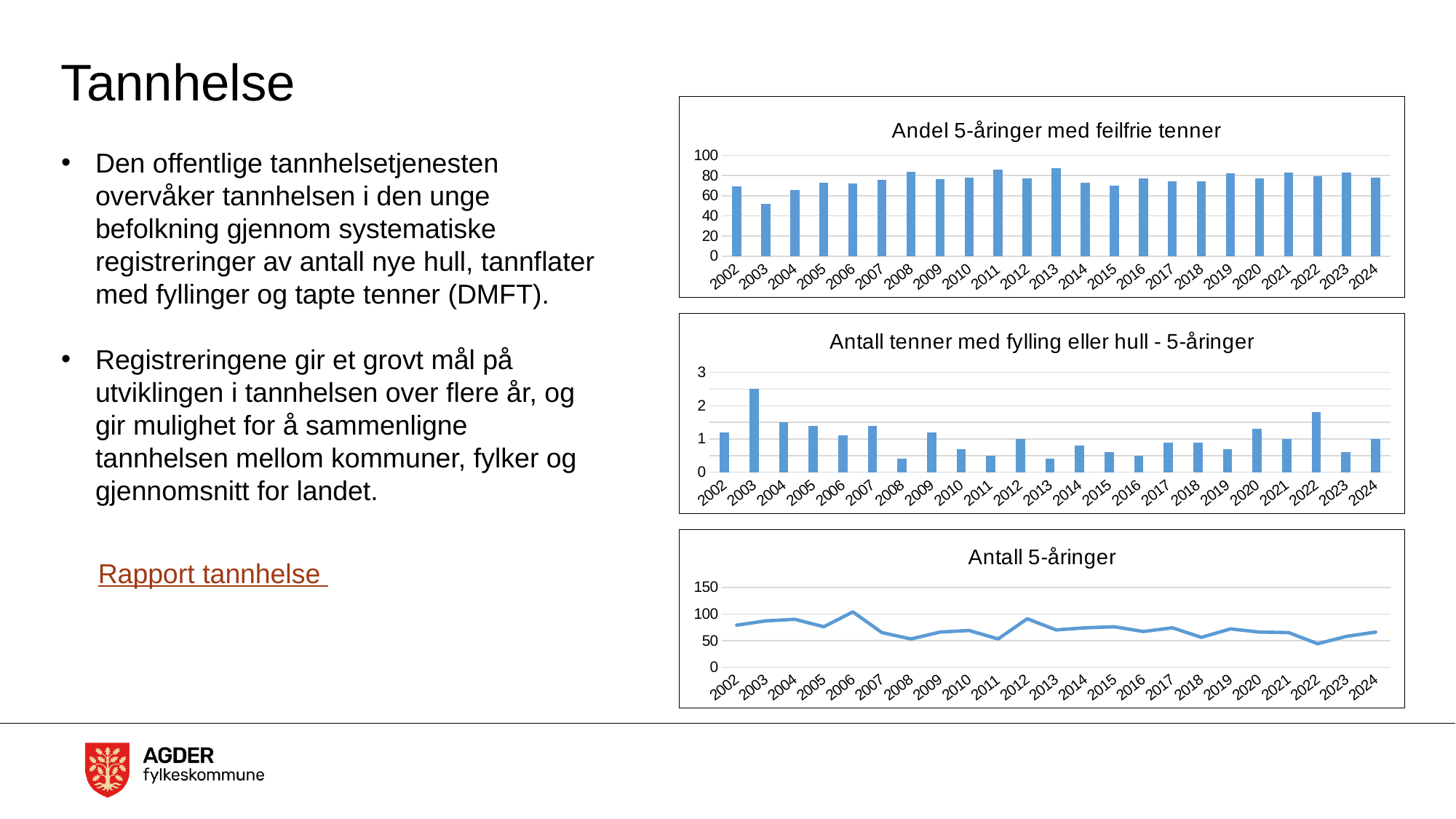
In the bottom chart 'Antall 5-åringer', which year has the lowest value? 2022 What type of chart is the bottom chart, 'Antall 5-åringer'? line chart In the top chart 'Andel 5-åringer med feilfrie tenner', is the value for 2008 greater or less than 80? greater In the top chart 'Andel 5-åringer med feilfrie tenner', is the value for 2003 greater or less than 60? less How many years are shown on the x axis of the top chart 'Andel 5-åringer med feilfrie tenner'? 23 In the middle chart 'Antall tenner med fylling eller hull - 5-åringer', is the value for 2008 greater or less than 1? less What type of chart is the top chart, 'Andel 5-åringer med feilfrie tenner'? bar chart In the bottom chart 'Antall 5-åringer', which year has the highest value? 2006 In the top chart 'Andel 5-åringer med feilfrie tenner', which year has the lowest value? 2003 In the middle chart 'Antall tenner med fylling eller hull - 5-åringer', which year has the highest value? 2003